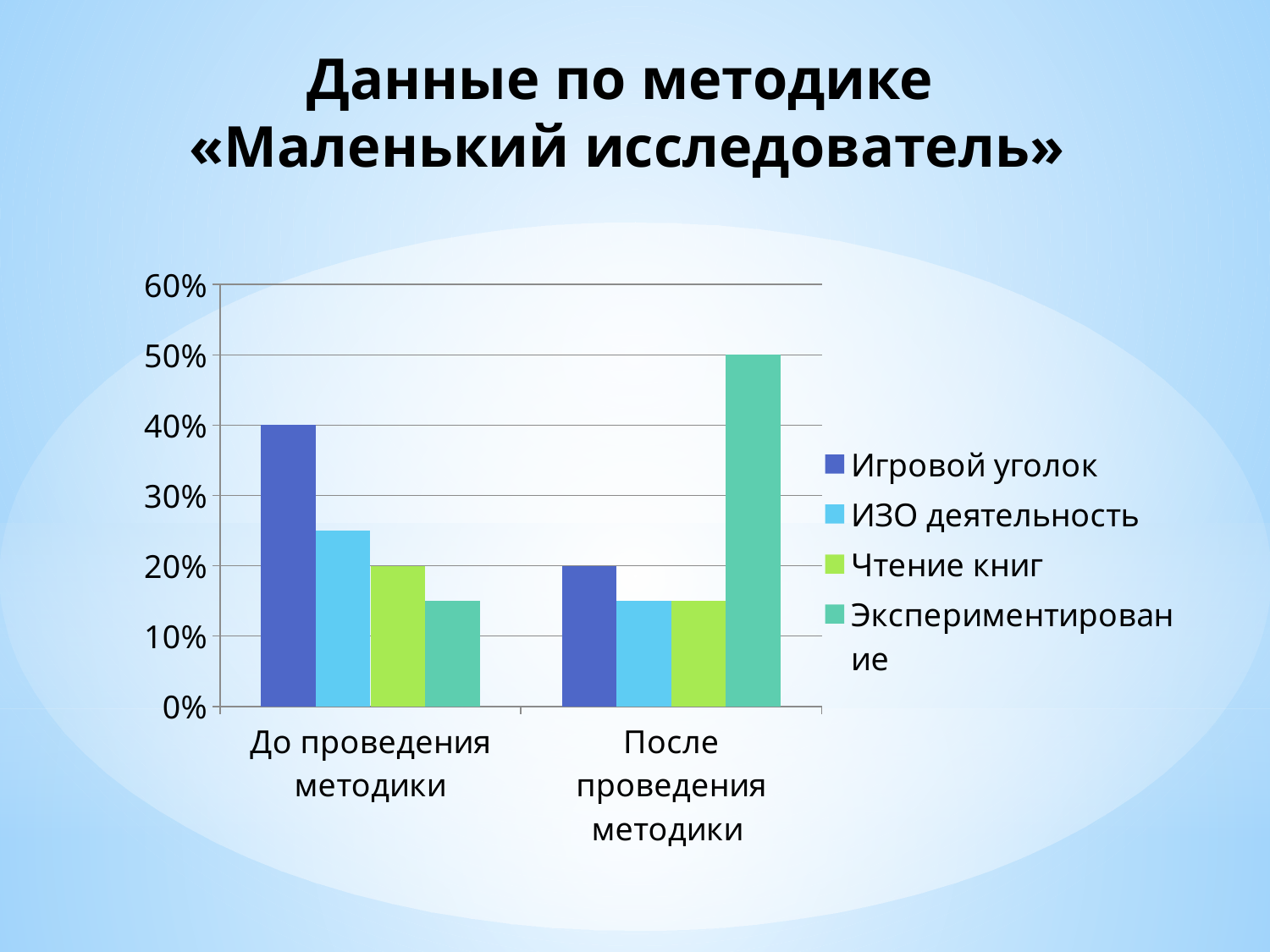
Which series has the lowest value in the category До проведения методики? Экспериментирование How many categories are shown on the x axis? 2 What is the value for Экспериментирование in the category После проведения методики? 50% What is the value for Игровой уголок in the category До проведения методики? 40% Which series has the highest value in the category После проведения методики? Экспериментирование What is the value for Чтение книг in the category До проведения методики? 20% Does the value for Экспериментирование rise or fall from До проведения методики to После проведения методики? Rise Is the value for ИЗО деятельность in the category До проведения методики greater or less than 20%? greater What type of chart is shown on the slide? Bar chart What is the difference between Экспериментирование and Игровой уголок in the category После проведения методики? 30% Which is larger for Игровой уголок: the value До проведения методики or После проведения методики? До проведения методики How many series does the legend list? 4